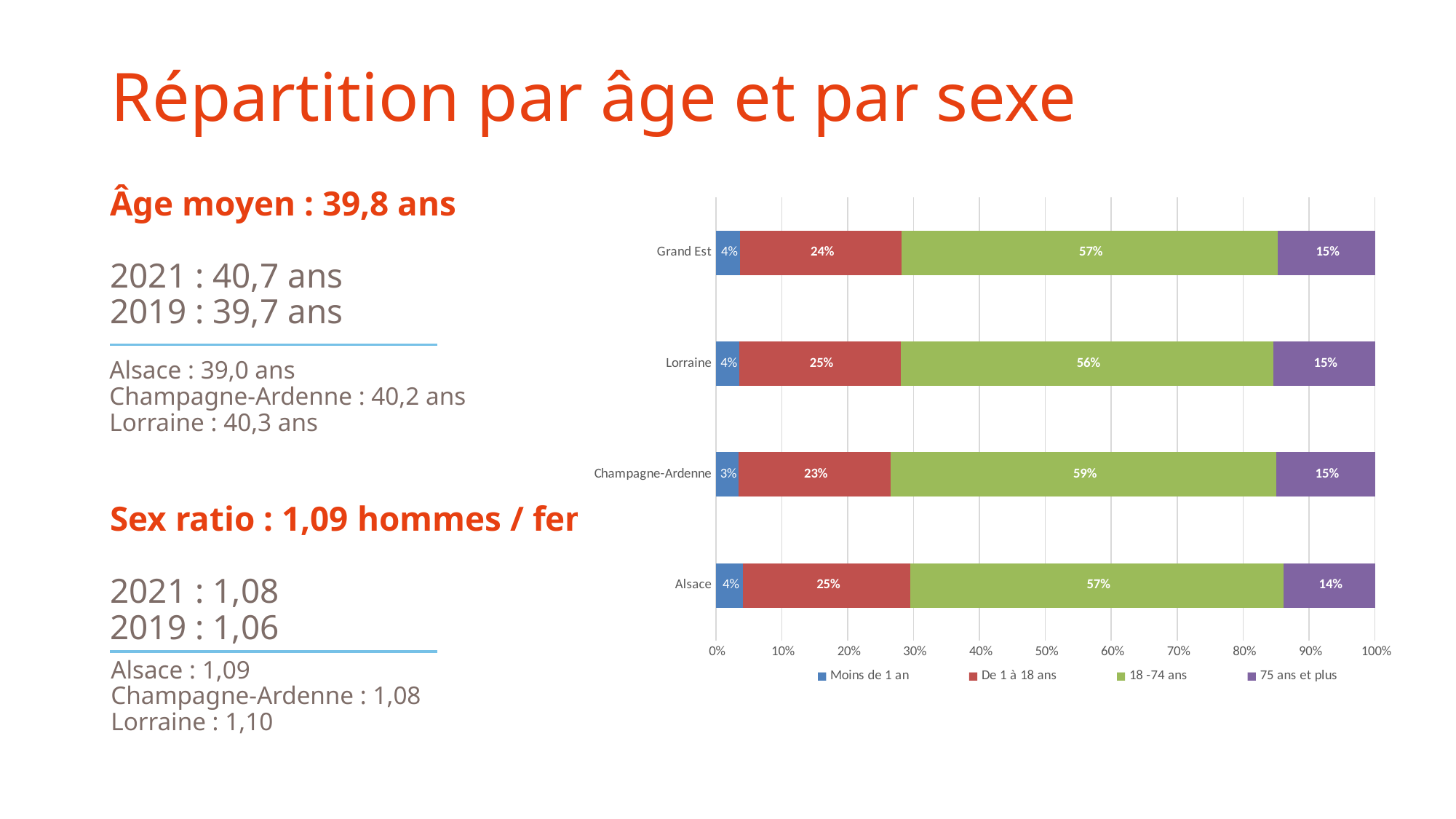
Which is larger: the 'De 1 à 18 ans' value for Lorraine or for Grand Est? Lorraine What is the value for '75 ans et plus' in Alsace? 14% What kind of chart is shown on the slide? Stacked bar chart What is the value for 'Moins de 1 an' in Champagne-Ardenne? 3% What is the value for '18 -74 ans' in Champagne-Ardenne? 59% What is the difference between the '18 -74 ans' values for Champagne-Ardenne and Lorraine? 3% What is the value for 'De 1 à 18 ans' in Grand Est? 24% Which region has the highest value for '18 -74 ans'? Champagne-Ardenne Which region has the lowest value for 'De 1 à 18 ans'? Champagne-Ardenne How many regions (categories) are shown in the chart? 4 How many series does the chart legend list? 4 Which series is shown in green in the chart? 18 -74 ans